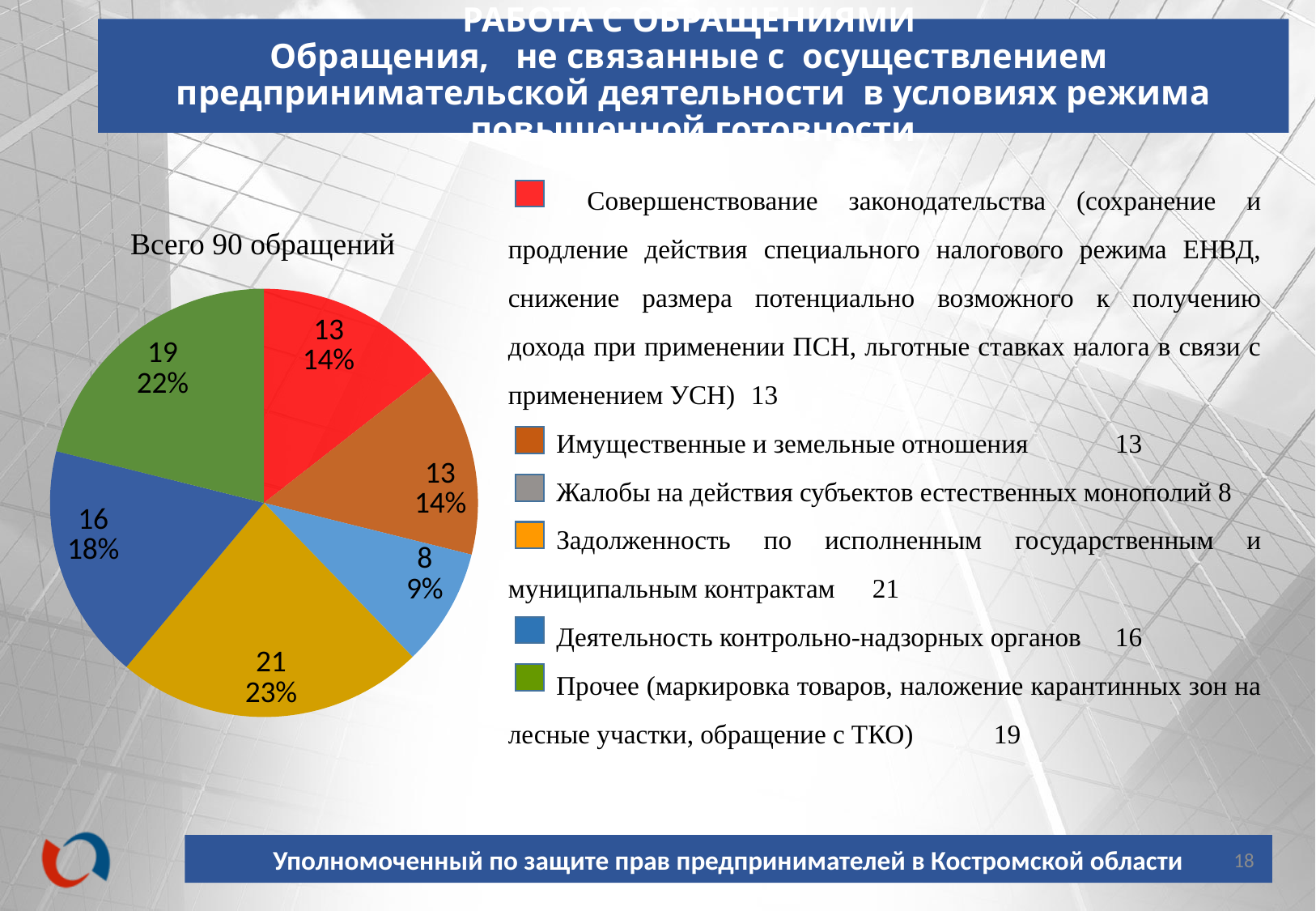
Какую долю составляют обращения по категории «Деятельность контрольно-надзорных органов»? 18% На сколько обращений категория «Прочее» превышает категорию «Деятельность контрольно-надзорных органов»? 3 Какую долю составляют обращения по категории «Совершенствование законодательства»? 14% Сколько категорий (секторов) показано на круговой диаграмме? 6 Какая категория имеет наибольшее число обращений? Задолженность по исполненным государственным и муниципальным контрактам Какая категория имеет наименьшее число обращений? Жалобы на действия субъектов естественных монополий Сколько обращений относится к категории «Жалобы на действия субъектов естественных монополий»? 8 Каким цветом на диаграмме обозначена категория «Прочее»? зелёным Сколько обращений приходится на категорию «Задолженность по исполненным государственным и муниципальным контрактам»? 21 Что больше: число обращений по категории «Прочее» или по категории «Имущественные и земельные отношения»? Прочее Какой тип диаграммы показан на слайде? круговая диаграмма Сколько всего обращений отражено на диаграмме? 90